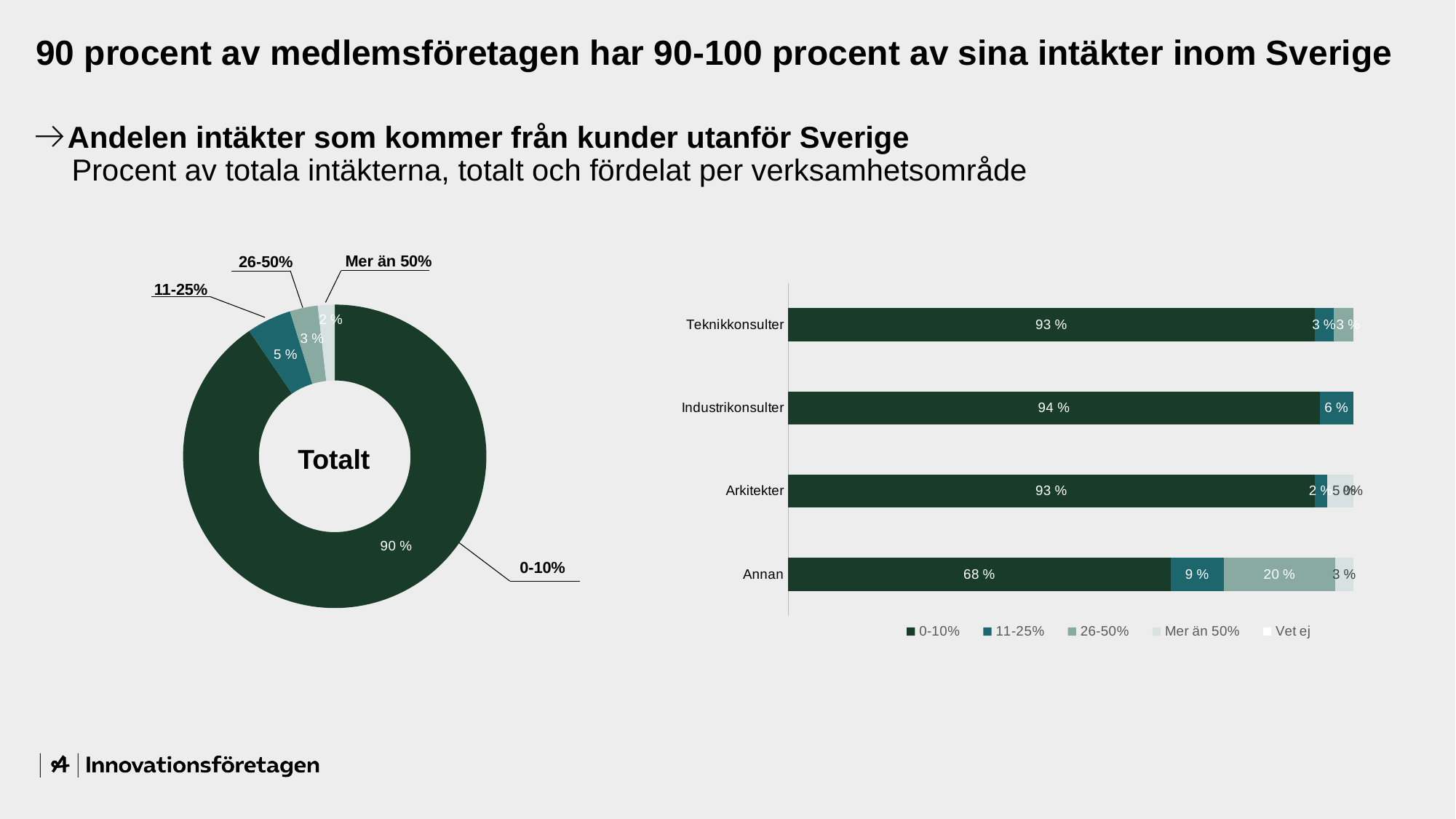
In the donut chart on the left, what is the value for the 11-25% slice? 5 % In the donut chart on the left, which category has the smallest share? Mer än 50% In the bar chart on the right, what is the 0-10% value for Industrikonsulter? 94 % In the donut chart on the left, how many slices are there? 4 In the bar chart on the right, what is the 26-50% value for Annan? 20 % In the bar chart on the right, what is the 11-25% value for Arkitekter? 2 % In the donut chart on the left, what share of companies have 0-10% of their revenue from customers outside Sweden? 90 % In the bar chart on the right, which category has the lowest 0-10% value? Annan In the bar chart on the right, what is the difference between the 0-10% values for Industrikonsulter and Annan? 26 % What type of chart is the chart on the left? Donut (pie) chart In the bar chart on the right, how many categories are shown on the vertical axis? 4 In the bar chart on the right, how many series does the legend list? 5